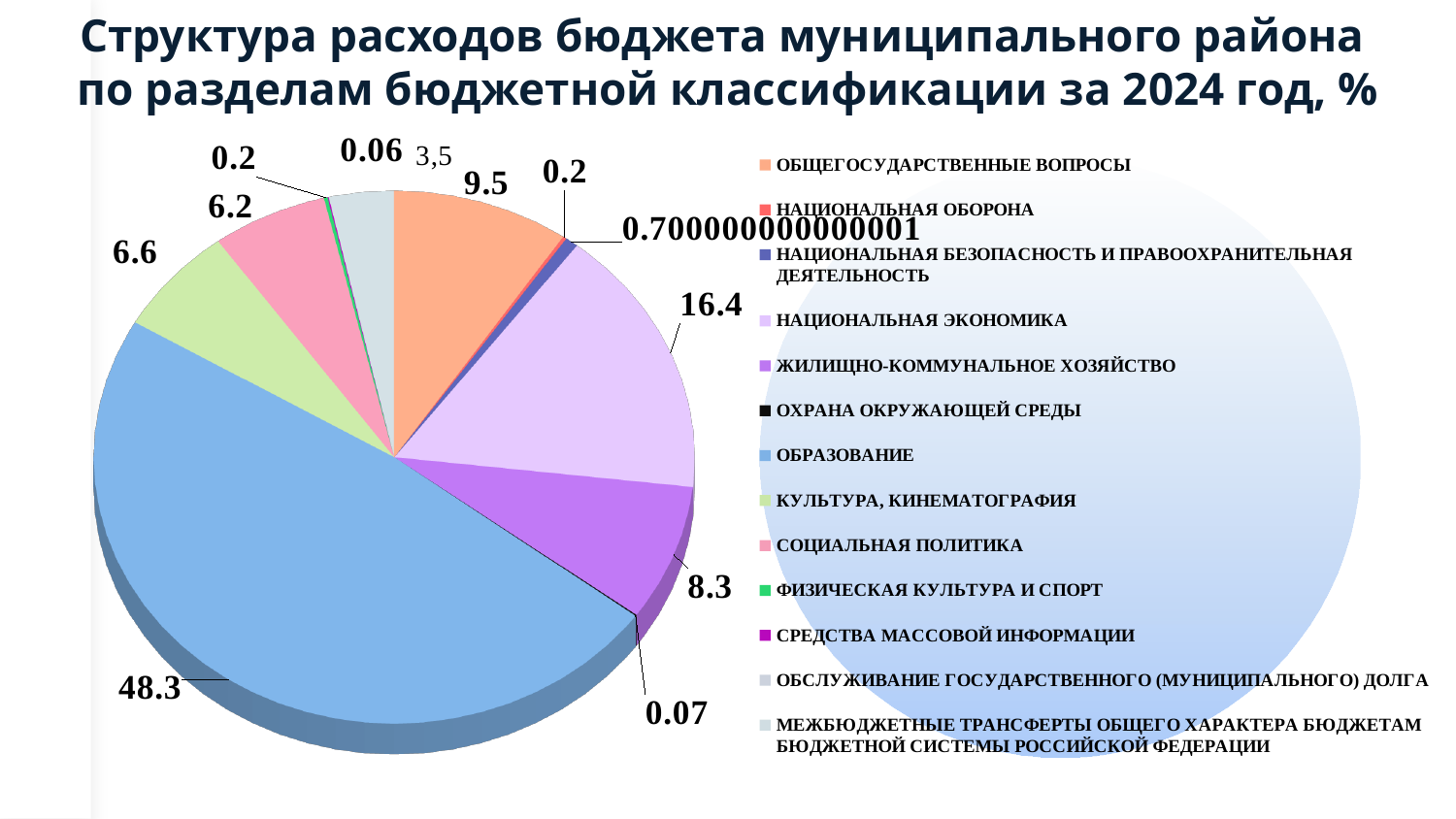
Which has a larger share: НАЦИОНАЛЬНАЯ ЭКОНОМИКА or ЖИЛИЩНО-КОММУНАЛЬНОЕ ХОЗЯЙСТВО? НАЦИОНАЛЬНАЯ ЭКОНОМИКА What year does the chart title say the budget expenditure structure refers to? 2024 What kind of chart is shown on the slide? pie chart What is the share of expenditures for ОБЩЕГОСУДАРСТВЕННЫЕ ВОПРОСЫ? 9.5 What is the difference between the shares of ОБРАЗОВАНИЕ and НАЦИОНАЛЬНАЯ ЭКОНОМИКА? 31.9 What is the share of expenditures for ОБРАЗОВАНИЕ? 48.3 What is the share of expenditures for ЖИЛИЩНО-КОММУНАЛЬНОЕ ХОЗЯЙСТВО? 8.3 What is the share of expenditures for НАЦИОНАЛЬНАЯ ЭКОНОМИКА? 16.4 Which section of the budget has the largest share of expenditures in the pie chart? ОБРАЗОВАНИЕ What is the share of expenditures for СОЦИАЛЬНАЯ ПОЛИТИКА? 6.2 How many entries does the legend of the pie chart list? 13 What is the share of expenditures for КУЛЬТУРА, КИНЕМАТОГРАФИЯ? 6.6